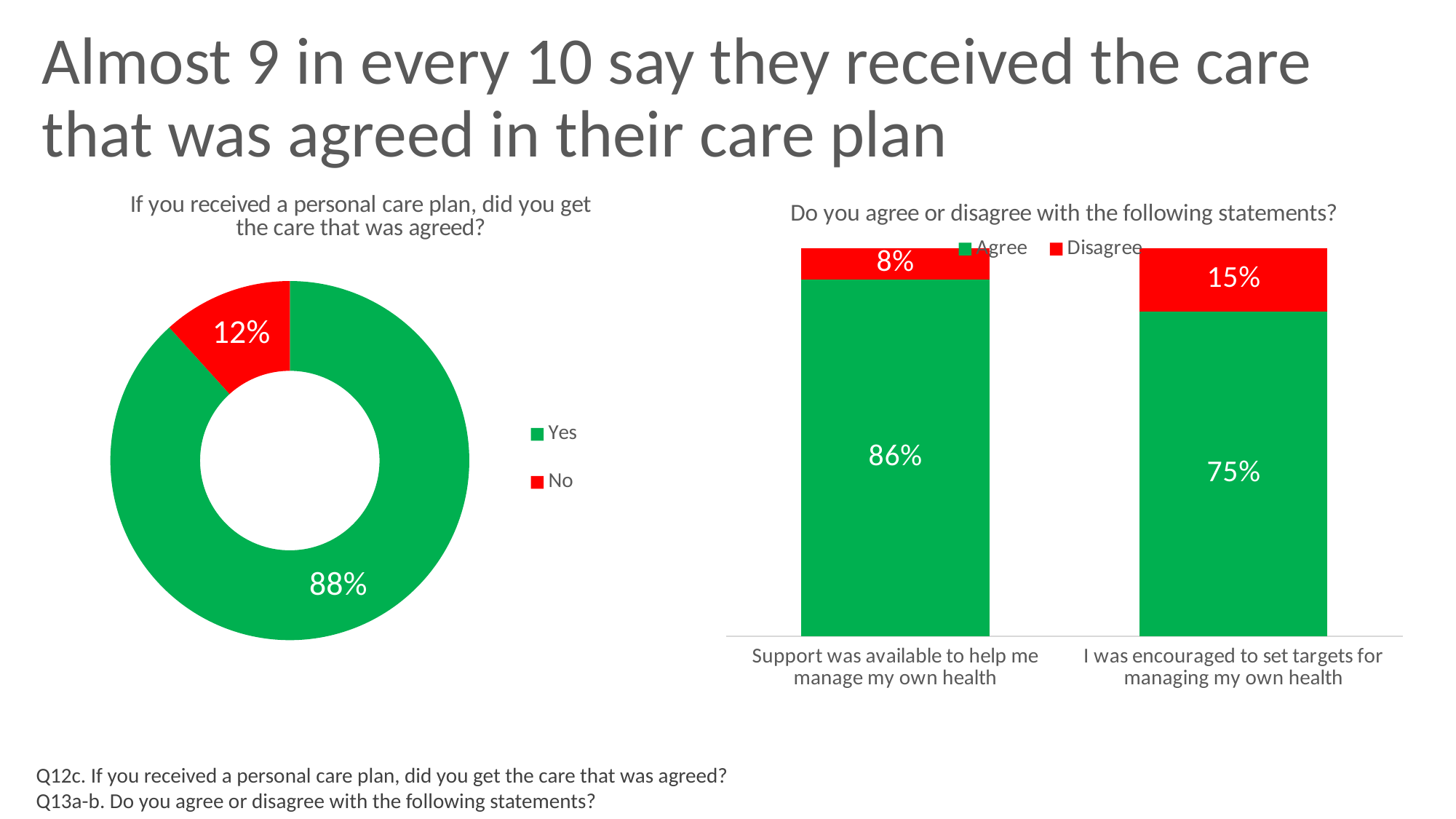
In the chart on the right, which statement has the higher Agree percentage? Support was available to help me manage my own health How many series does the legend of the chart on the right list? 2 In the chart on the left, which response has the larger share, Yes or No? Yes In the chart titled 'If you received a personal care plan, did you get the care that was agreed?', what percentage answered No? 12% What kind of chart is the one on the right of the slide? Stacked bar chart In the chart on the left, what is the difference between the Yes and No shares? 76% In the chart on the right, what percentage disagreed that support was available to help me manage my own health? 8% In the chart on the right, what is the difference between the Agree percentages for the two statements? 11% In the chart titled 'Do you agree or disagree with the following statements?', what percentage disagreed that they were encouraged to set targets for managing their own health? 15% In the chart titled 'If you received a personal care plan, did you get the care that was agreed?', what percentage answered Yes? 88% What kind of chart is the one on the left of the slide? Doughnut chart In the chart titled 'Do you agree or disagree with the following statements?', what percentage agreed that support was available to help me manage my own health? 86%